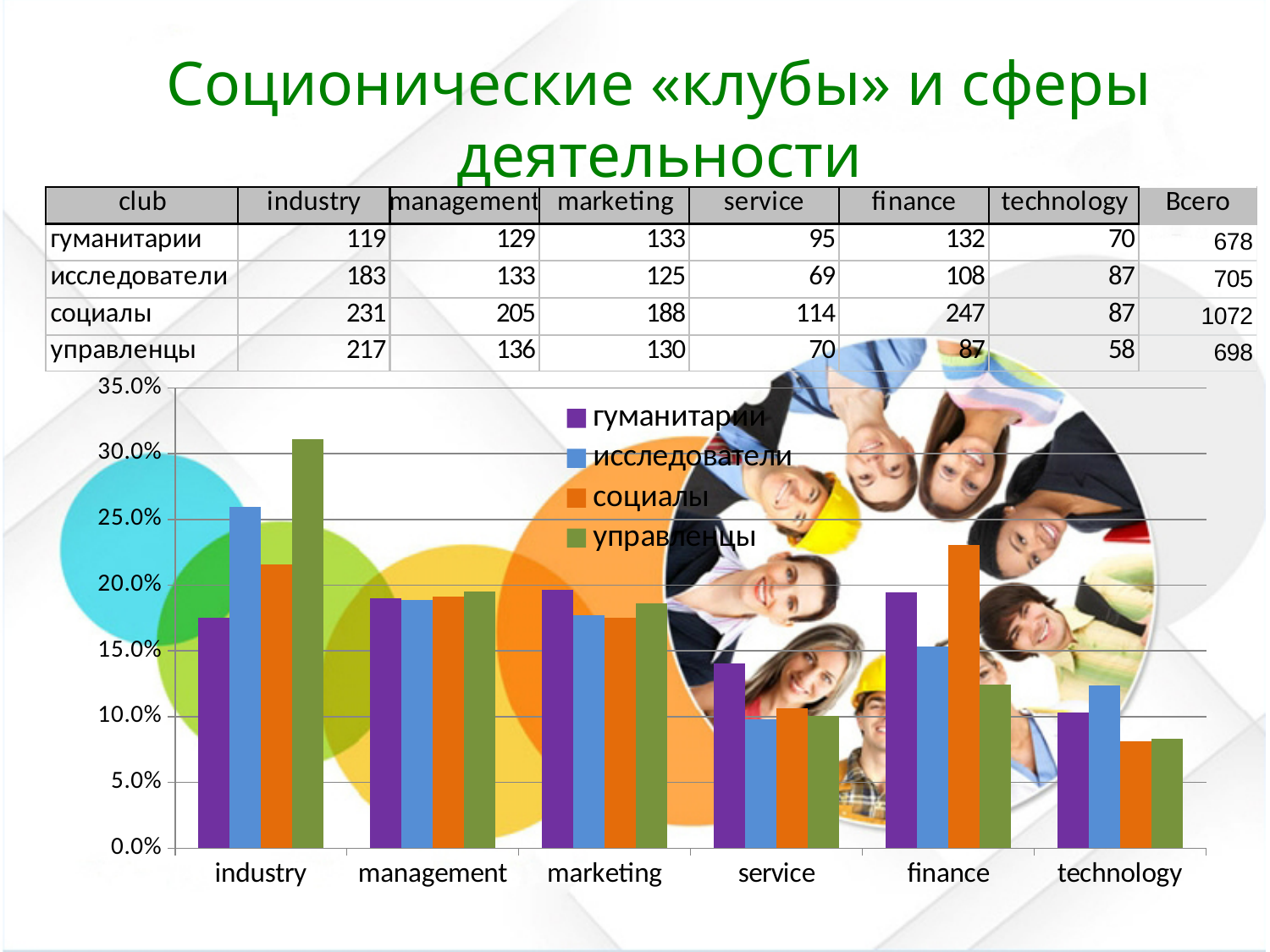
Is the value for социалы in the technology category greater or less than 10.0%? less How many categories are shown on the x axis of the chart? 6 Which series has the highest bar in the finance category? социалы What colour are the bars for the социалы series in the chart? orange Is the value for гуманитарии in the service category greater or less than 10.0%? greater Which series has the highest bar in the industry category? управленцы Is the value for социалы in the finance category greater or less than 20.0%? greater Which series has the lowest bar in the finance category? управленцы How many series does the chart legend list? 4 What kind of chart is shown on the slide? bar chart In the marketing category, which is larger: the bar for гуманитарии or the bar for исследователи? гуманитарии